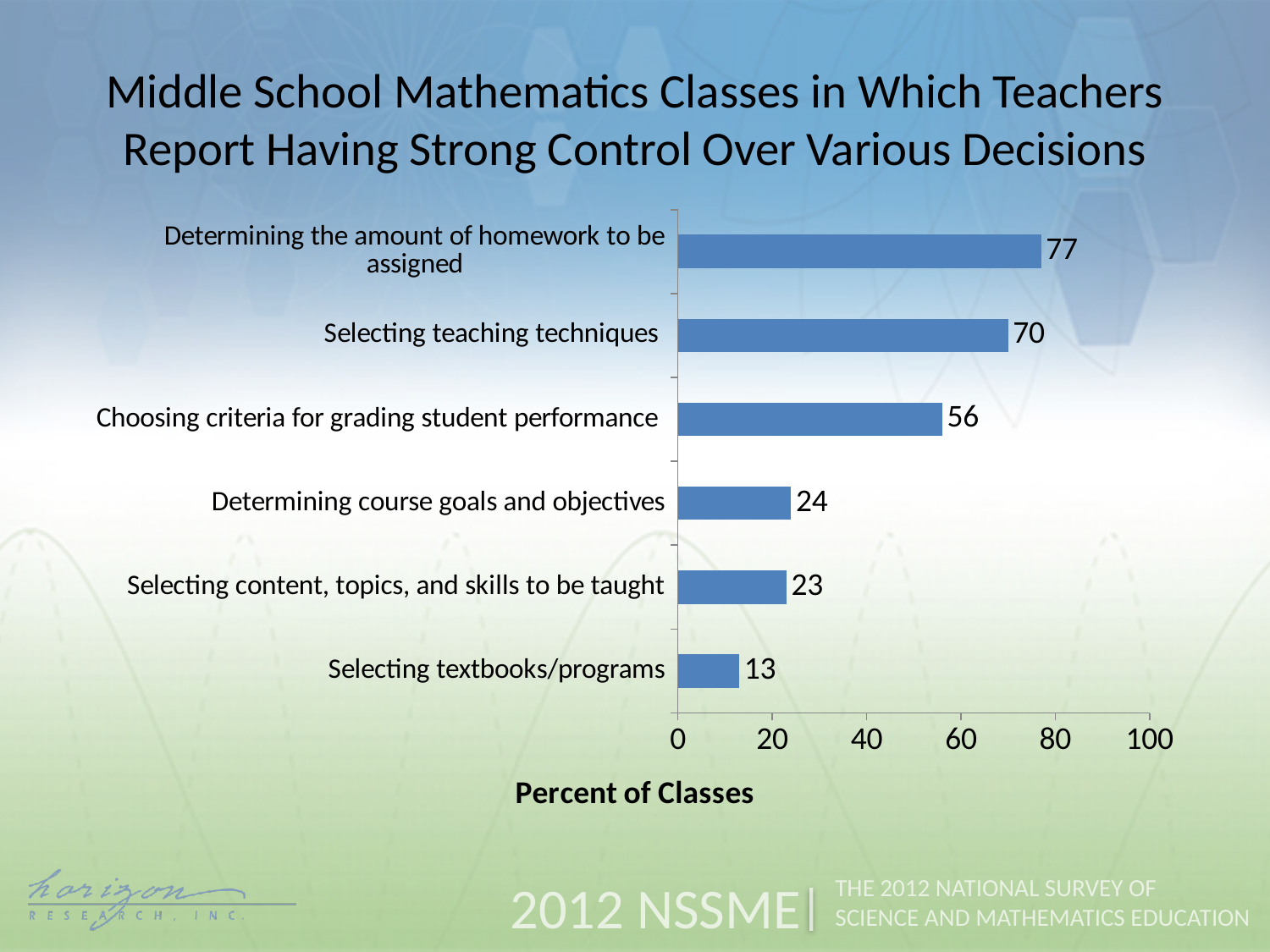
What is the difference between the values for 'Choosing criteria for grading student performance' and 'Selecting textbooks/programs'? 43 Which is larger: the value for 'Determining course goals and objectives' or 'Selecting content, topics, and skills to be taught'? Determining course goals and objectives Is the value for 'Choosing criteria for grading student performance' greater or less than 60? less What is the difference between the values for 'Determining the amount of homework to be assigned' and 'Selecting teaching techniques'? 7 Which decision has the lowest percent of classes? Selecting textbooks/programs How many decision categories are shown in the chart? 6 What percent of classes is shown for 'Selecting teaching techniques'? 70 What kind of chart is shown on the slide? Bar chart What is the value for 'Choosing criteria for grading student performance'? 56 Which decision has the highest percent of classes? Determining the amount of homework to be assigned What is the value for 'Selecting textbooks/programs'? 13 What is the label of the horizontal axis? Percent of Classes